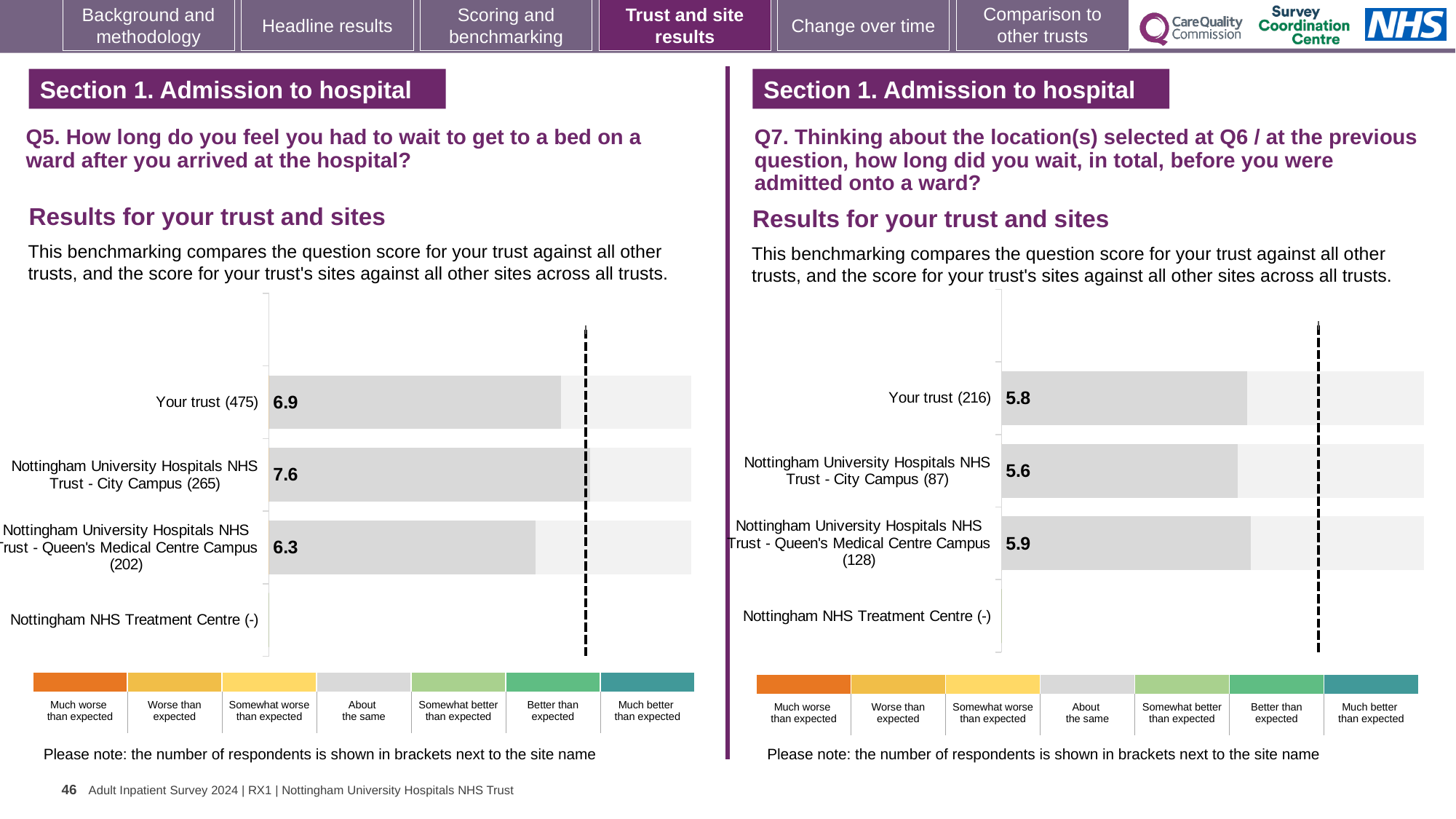
On the left chart (Q5), what is the score for Nottingham University Hospitals NHS Trust - Queen's Medical Centre Campus (202)? 6.3 On the left chart (Q5), which site or trust has the highest score? Nottingham University Hospitals NHS Trust - City Campus (265) On the left chart (Q5), what is the difference between the City Campus score and the Queen's Medical Centre Campus score? 1.3 On the right chart (Q7), what is the score for Nottingham University Hospitals NHS Trust - City Campus (87)? 5.6 What kind of chart is used on the left (Q5) to show the results for your trust and sites? Bar chart On the right chart (Q7), what is the difference between the Queen's Medical Centre Campus score and the City Campus score? 0.3 On the right chart (Q7), what is the score for Nottingham University Hospitals NHS Trust - Queen's Medical Centre Campus (128)? 5.9 On the left chart (Q5), what is the score for Your trust (475)? 6.9 On the left chart (Q5), what is the score for Nottingham University Hospitals NHS Trust - City Campus (265)? 7.6 On the right chart (Q7), what is the score for Your trust (216)? 5.8 On the right chart (Q7), which site or trust has the lowest score? Nottingham University Hospitals NHS Trust - City Campus (87) On the left chart (Q5), how many sites or trusts are listed on the vertical axis? 4